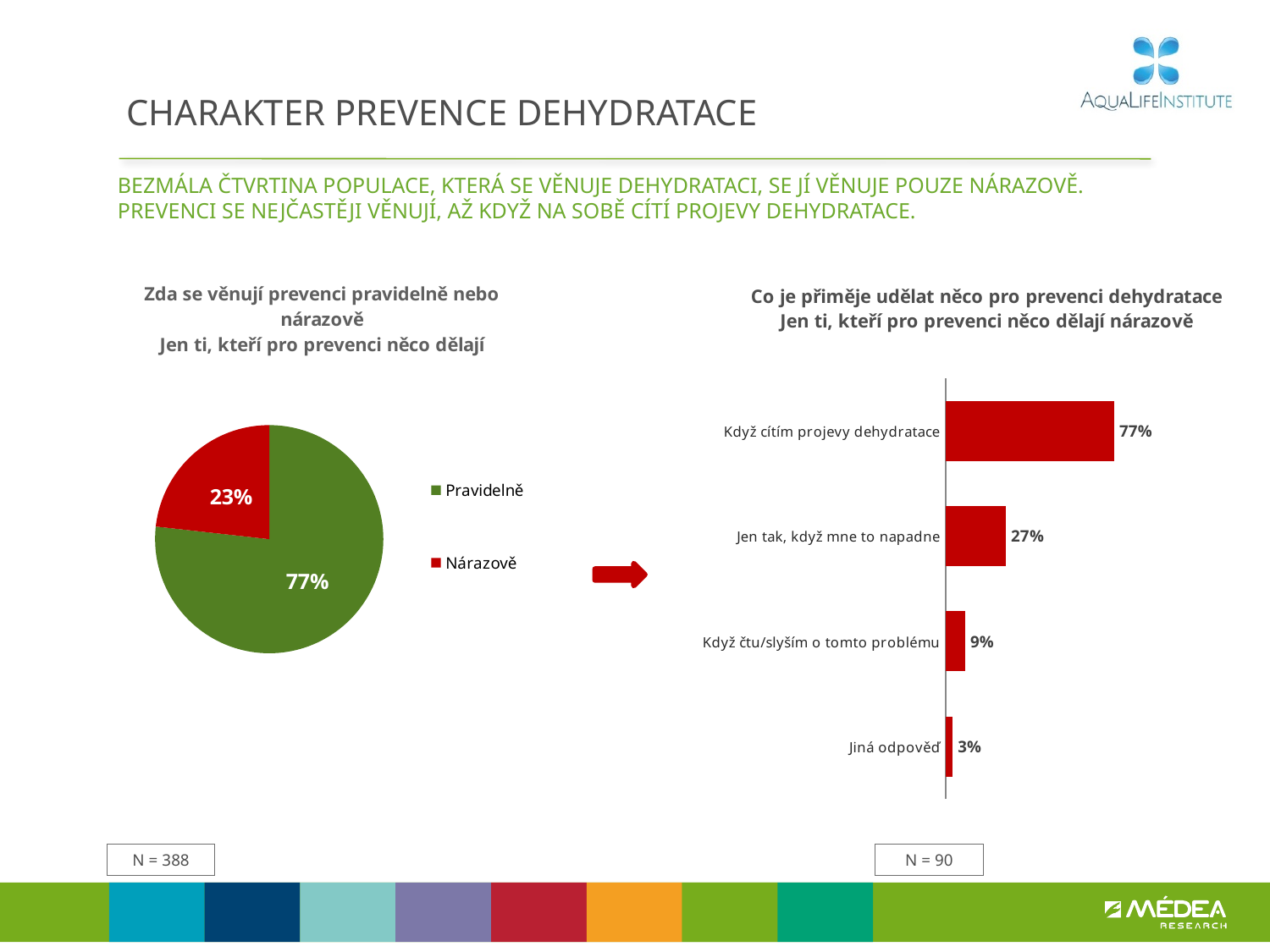
In the bar chart on the right, which category has the highest value? Když cítím projevy dehydratace What kind of chart is the chart on the left of the slide? Pie chart In the bar chart on the right, what is the value for Když cítím projevy dehydratace? 77% In the pie chart on the left, what share is labelled for Nárazově? 23% What kind of chart is the chart on the right of the slide? Bar chart How many categories does the bar chart on the right show? 4 In the pie chart on the left, how many entries does the legend list? 2 In the bar chart on the right, what is the value for Jen tak, když mne to napadne? 27% In the pie chart on the left, what share is labelled for Pravidelně? 77% In the pie chart on the left, which category has the larger slice, Pravidelně or Nárazově? Pravidelně In the bar chart on the right, which category has the lowest value? Jiná odpověď In the bar chart on the right, what is the difference between Když cítím projevy dehydratace and Jen tak, když mne to napadne? 50%